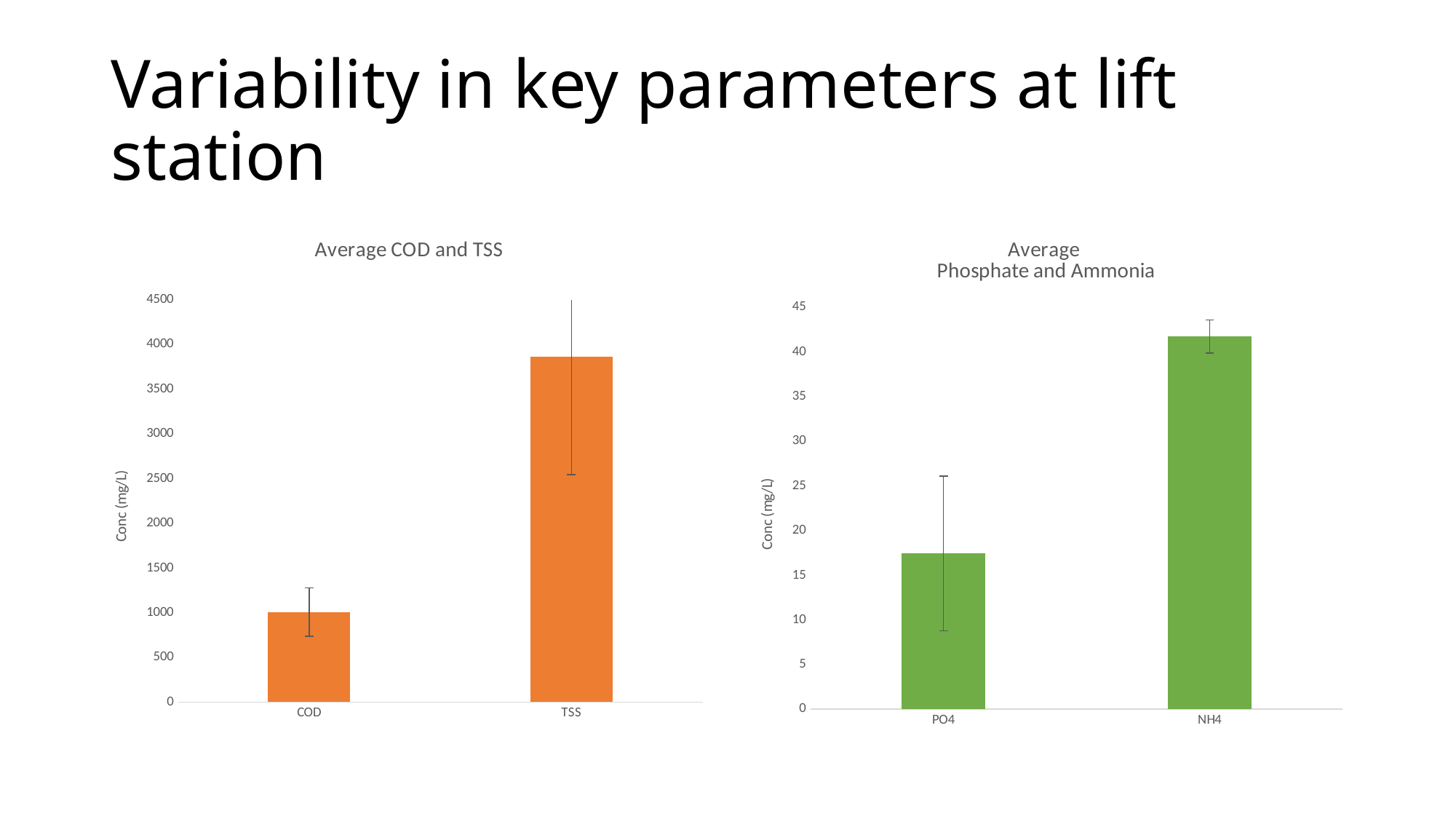
In the "Average COD and TSS" chart, is the value for TSS greater or less than 3500? greater What is the y-axis label of the "Average COD and TSS" chart? Conc (mg/L) What kind of chart is the "Average Phosphate and Ammonia" chart? bar chart In the "Average COD and TSS" chart, which category has the highest value? TSS In the "Average Phosphate and Ammonia" chart, is the value for NH4 greater or less than 40? greater In the "Average COD and TSS" chart, which category has the lowest value? COD How many categories are shown in the "Average Phosphate and Ammonia" chart? 2 In the "Average Phosphate and Ammonia" chart, is the value for PO4 greater or less than 20? less How many categories are shown in the "Average COD and TSS" chart? 2 In the "Average Phosphate and Ammonia" chart, which is larger, PO4 or NH4? NH4 What kind of chart is the "Average COD and TSS" chart? bar chart